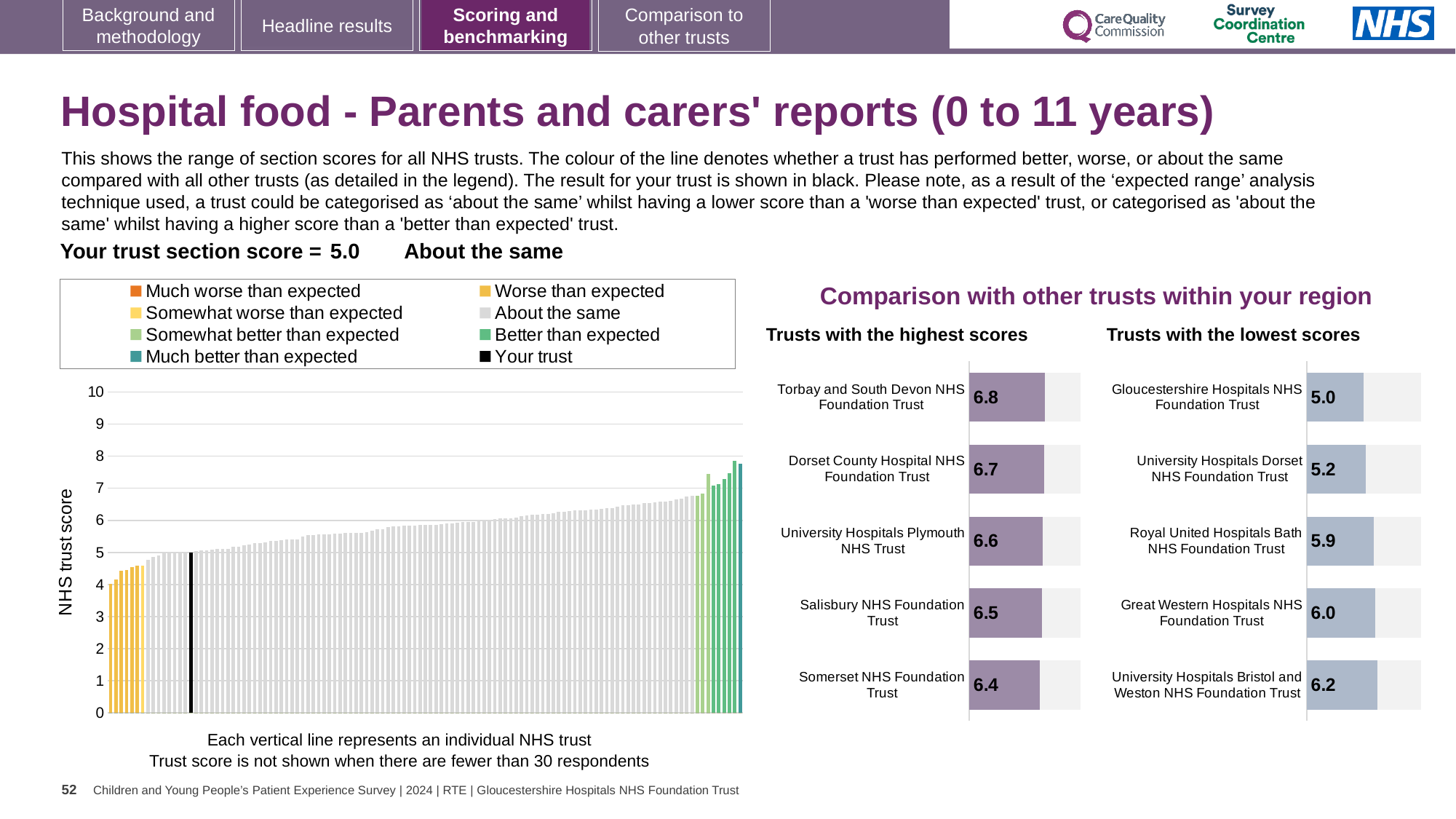
In the 'Trusts with the highest scores' chart, what is the difference between the scores of Torbay and South Devon NHS Foundation Trust and Somerset NHS Foundation Trust? 0.4 In the 'Trusts with the highest scores' chart, what is the score for Torbay and South Devon NHS Foundation Trust? 6.8 In the 'Trusts with the highest scores' chart, which trust has the highest score? Torbay and South Devon NHS Foundation Trust In the 'Trusts with the lowest scores' chart, what is the difference between the scores of University Hospitals Bristol and Weston NHS Foundation Trust and Gloucestershire Hospitals NHS Foundation Trust? 1.2 In the 'Trusts with the lowest scores' chart, which has the higher score: Great Western Hospitals NHS Foundation Trust or University Hospitals Dorset NHS Foundation Trust? Great Western Hospitals NHS Foundation Trust In the 'Trusts with the highest scores' chart, what is the score for Salisbury NHS Foundation Trust? 6.5 How many entries does the legend of the large chart on the left list? 8 In the large chart on the left showing the range of section scores, do the bar values rise or fall from left to right? rise In the 'Trusts with the lowest scores' chart, which trust has the lowest score? Gloucestershire Hospitals NHS Foundation Trust How many trusts are listed in the 'Trusts with the highest scores' chart? 5 In the large chart on the left showing the range of section scores, is the value of the tallest bar greater or less than 7? greater In the 'Trusts with the lowest scores' chart, what is the score for Royal United Hospitals Bath NHS Foundation Trust? 5.9